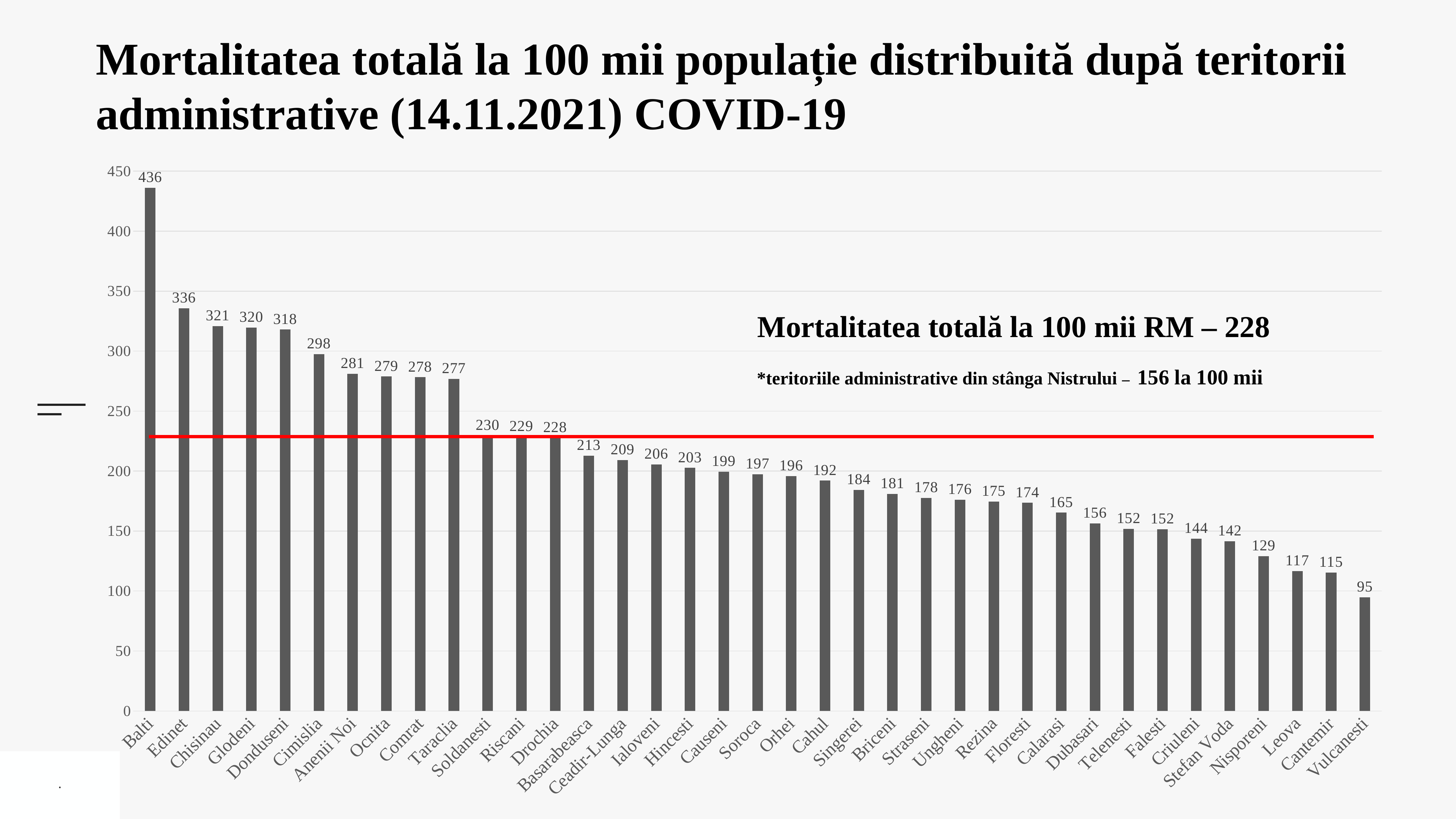
Do the values rise or fall from left to right along the x axis? Fall What is the value for Chisinau? 321 What is the value for Balti? 436 What is the difference between the values for Balti and Edinet? 100 Which territory has the highest value? Balti What kind of chart is shown on the slide? Bar chart What is the value for Cahul? 192 Which is larger, the value for Cimislia or the value for Soroca? Cimislia What is the difference between the values for Drochia and Vulcanesti? 133 Which territory has the lowest value? Vulcanesti What is the value for Stefan Voda? 142 How many territories are shown on the x axis? 37